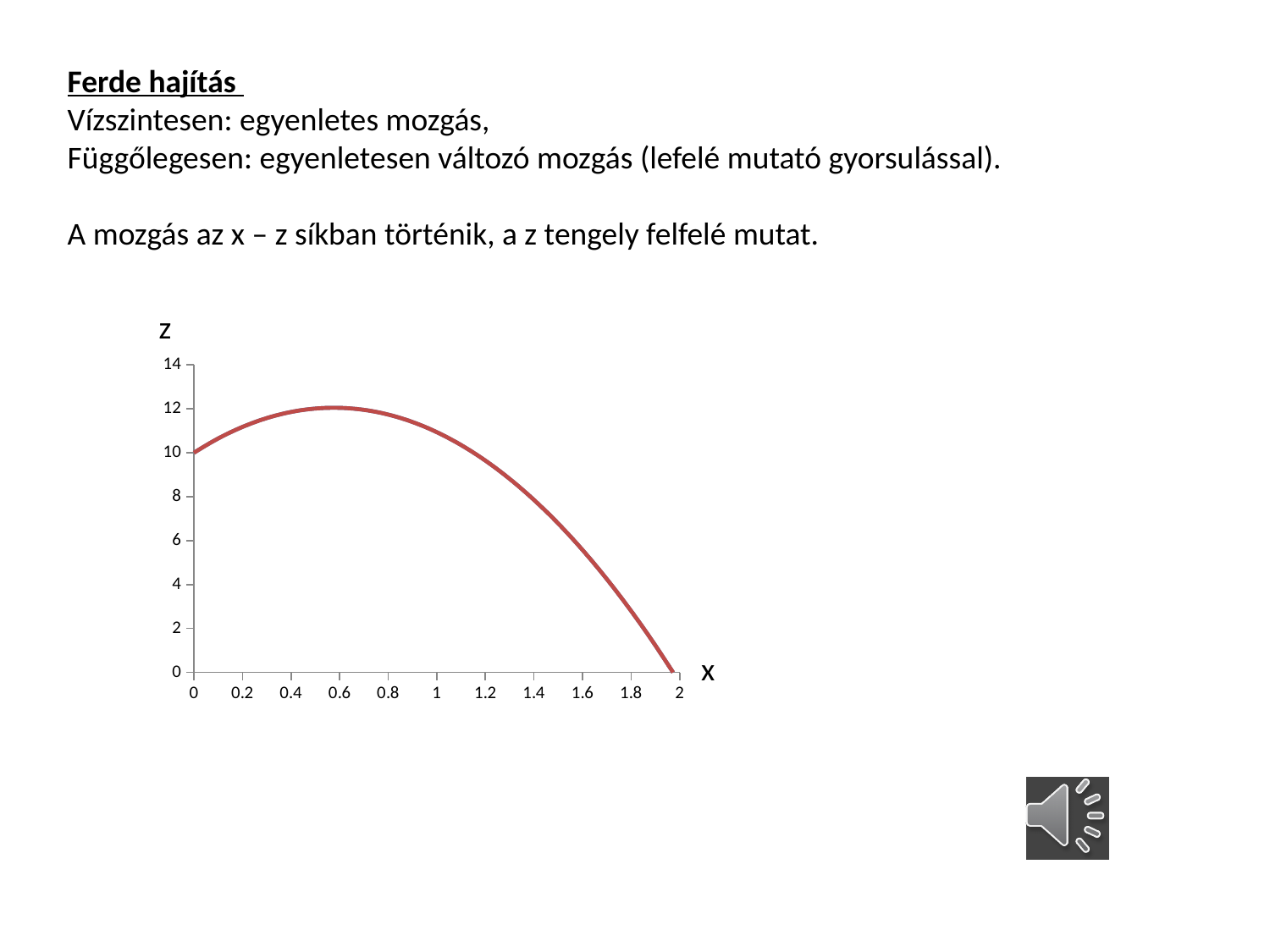
Which is larger, z at x = 0.4 or z at x = 1.4? z at x = 0.4 Is the value of z at x = 0.2 greater or less than 10? greater What is the label of the horizontal axis? x How does z change as x increases from 0 to 2? rises then falls Is the value of z at x = 1.8 greater or less than 4? less What kind of chart is shown on the slide? line chart What is the label of the vertical axis? z Is the value of z at x = 1.6 greater or less than 8? less Does z rise or fall as x increases from 1 to 1.8? fall What is the value of z at x = 0? 10